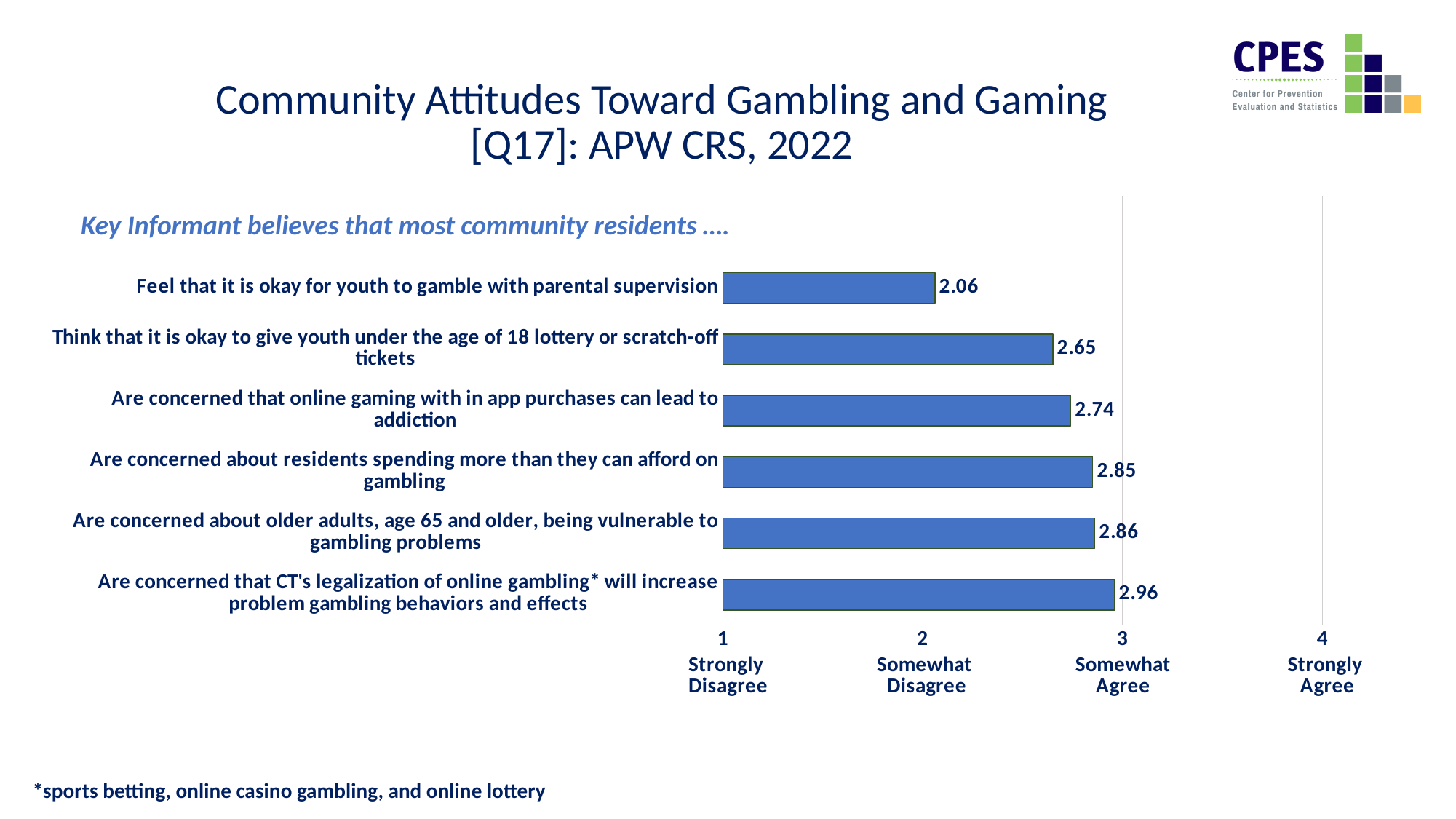
Which category has the highest value? Are concerned that CT's legalization of online gambling* will increase problem gambling behaviors and effects Which category has the lowest value? Feel that it is okay for youth to gamble with parental supervision What is the difference between the value for "Are concerned that CT's legalization of online gambling* will increase problem gambling behaviors and effects" and the value for "Feel that it is okay for youth to gamble with parental supervision"? 0.90 How many categories are shown in the chart? 6 What is the value for "Are concerned that CT's legalization of online gambling* will increase problem gambling behaviors and effects"? 2.96 Is the value for "Feel that it is okay for youth to gamble with parental supervision" greater or less than 3? less What label does the x axis show at the value 4? Strongly Agree What is the value for "Feel that it is okay for youth to gamble with parental supervision"? 2.06 What is the value for "Are concerned about residents spending more than they can afford on gambling"? 2.85 What is the value for "Think that it is okay to give youth under the age of 18 lottery or scratch-off tickets"? 2.65 Which is larger: the value for "Are concerned that online gaming with in app purchases can lead to addiction" or the value for "Think that it is okay to give youth under the age of 18 lottery or scratch-off tickets"? Are concerned that online gaming with in app purchases can lead to addiction What kind of chart is shown on the slide? bar chart